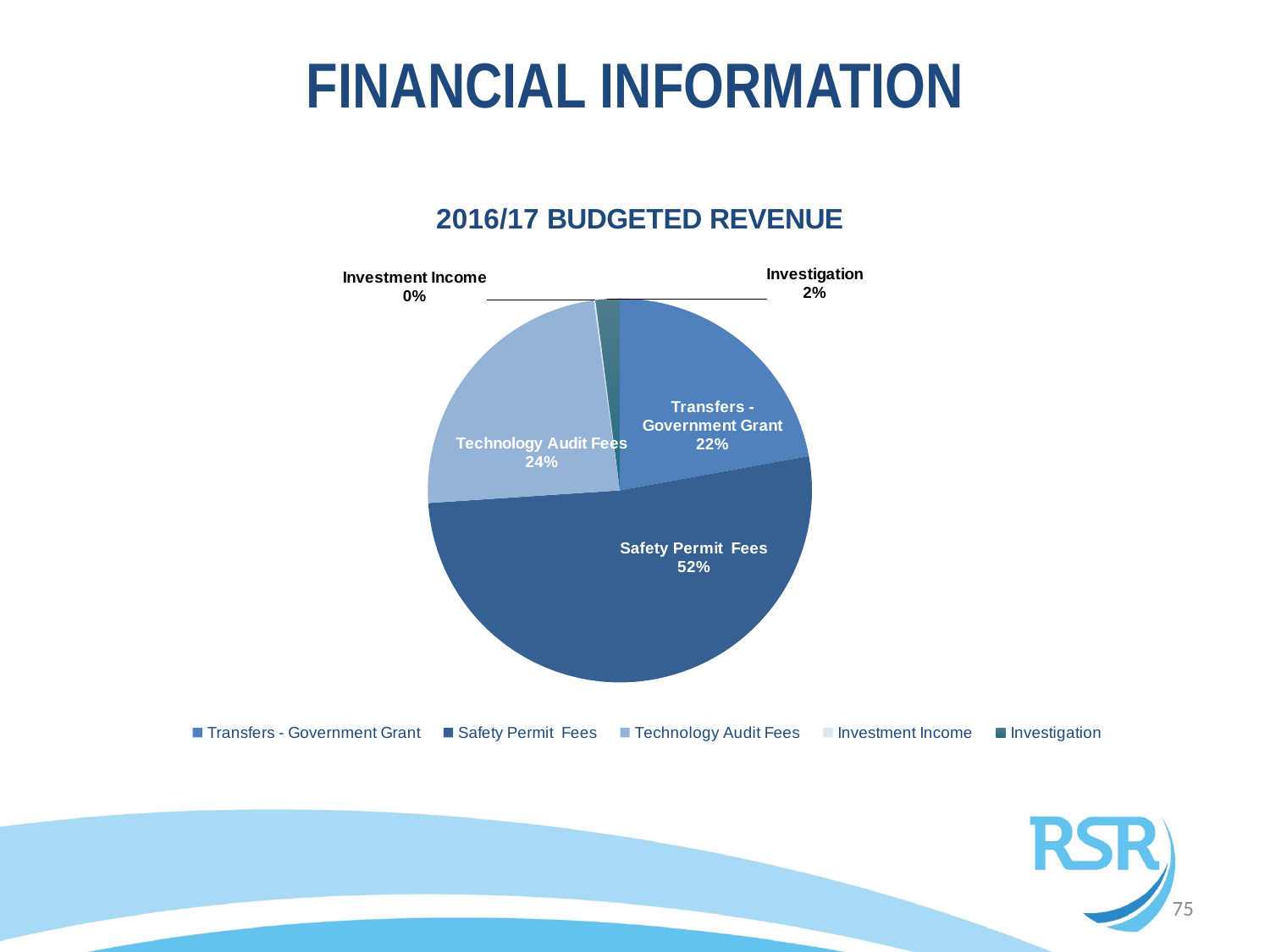
What share of budgeted revenue comes from Technology Audit Fees? 24% What is the title of the chart? 2016/17 BUDGETED REVENUE Which revenue source has the smallest share of the pie? Investment Income What is the difference in percentage points between Safety Permit Fees and Technology Audit Fees? 28 What share of budgeted revenue comes from Safety Permit Fees? 52% What share of budgeted revenue comes from Investment Income? 0% What kind of chart is shown on the slide? pie chart Which is larger, the share for Technology Audit Fees or the share for Transfers - Government Grant? Technology Audit Fees Which revenue source has the largest share of the pie? Safety Permit Fees What share of budgeted revenue comes from Transfers - Government Grant? 22% How many revenue categories does the legend list? 5 What share of budgeted revenue comes from Investigation? 2%